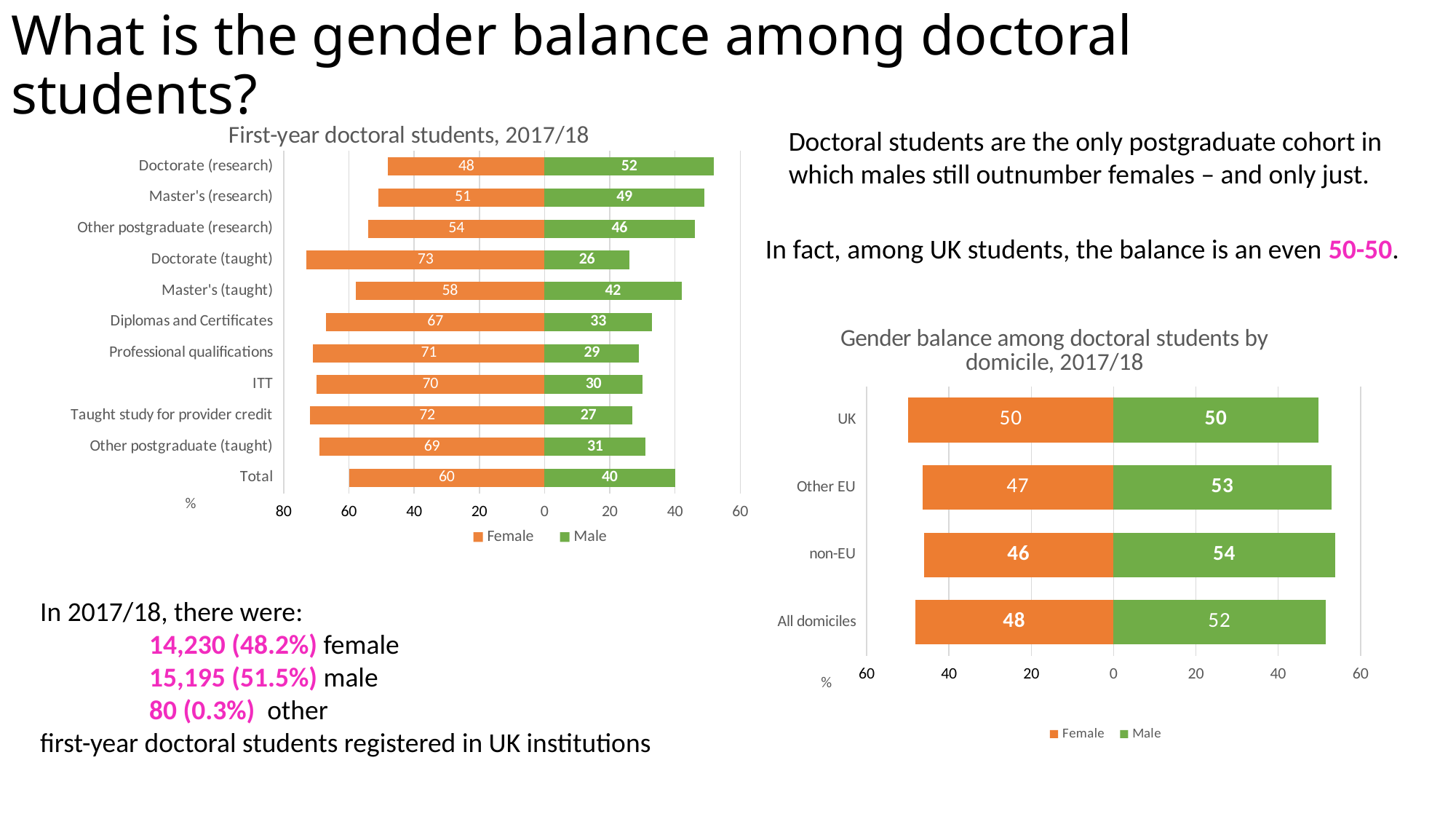
In the 'Gender balance among doctoral students by domicile, 2017/18' chart, which domicile has the highest Female value? UK In the 'First-year doctoral students, 2017/18' chart, what is the Female value for Doctorate (taught)? 73 In the 'First-year doctoral students, 2017/18' chart, what is the Male value for Master's (taught)? 42 In the 'First-year doctoral students, 2017/18' chart, is the Female value for Professional qualifications greater or less than the Male value? greater In the 'Gender balance among doctoral students by domicile, 2017/18' chart, what is the Male value for non-EU? 54 What kind of chart is the 'Gender balance among doctoral students by domicile, 2017/18' chart? bar chart In the 'First-year doctoral students, 2017/18' chart, how many categories are shown on the y axis? 11 In the 'Gender balance among doctoral students by domicile, 2017/18' chart, what is the Female value for Other EU? 47 In the 'First-year doctoral students, 2017/18' chart, which category has the lowest Female value? Doctorate (research) In the 'Gender balance among doctoral students by domicile, 2017/18' chart, how many series does the legend list? 2 In the 'First-year doctoral students, 2017/18' chart, which category has the highest Male value? Doctorate (research) In the 'First-year doctoral students, 2017/18' chart, what is the difference between the Female and Male values for Total? 20